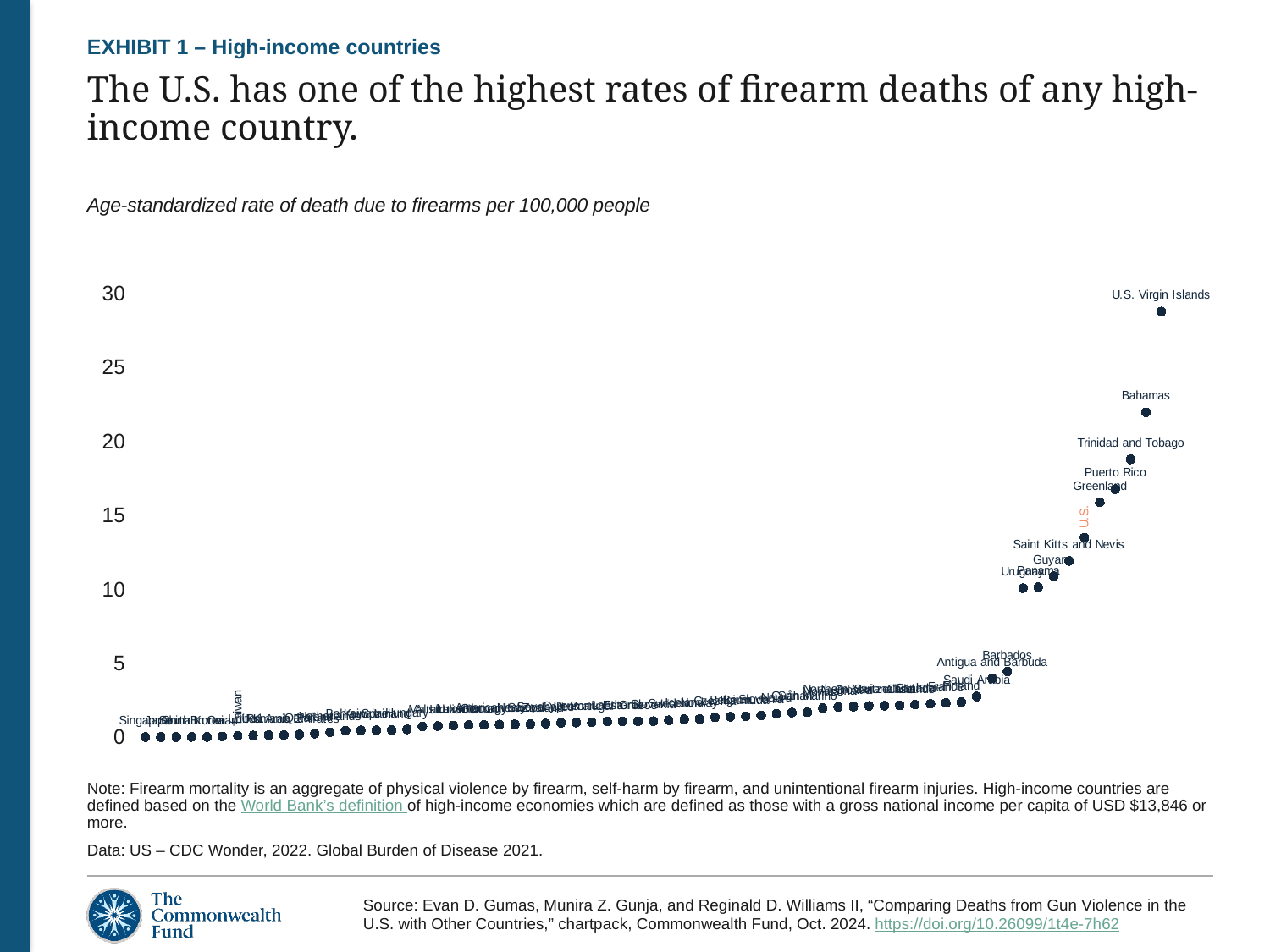
Which has a higher firearm death rate, the Bahamas or the U.S.? Bahamas Do the plotted values rise or fall moving from left to right along the x axis? rise Is the value for the Bahamas greater or less than 20? greater Which country has the highest age-standardized rate of death due to firearms on the chart? U.S. Virgin Islands What kind of chart is shown on the slide? scatter (dot) chart What measure does the chart plot, according to the subtitle? Age-standardized rate of death due to firearms per 100,000 people Which has a higher firearm death rate, the U.S. or Saint Kitts and Nevis? U.S. Is the value for the U.S. Virgin Islands greater or less than 25? greater Is the value for Saudi Arabia greater or less than 5? less